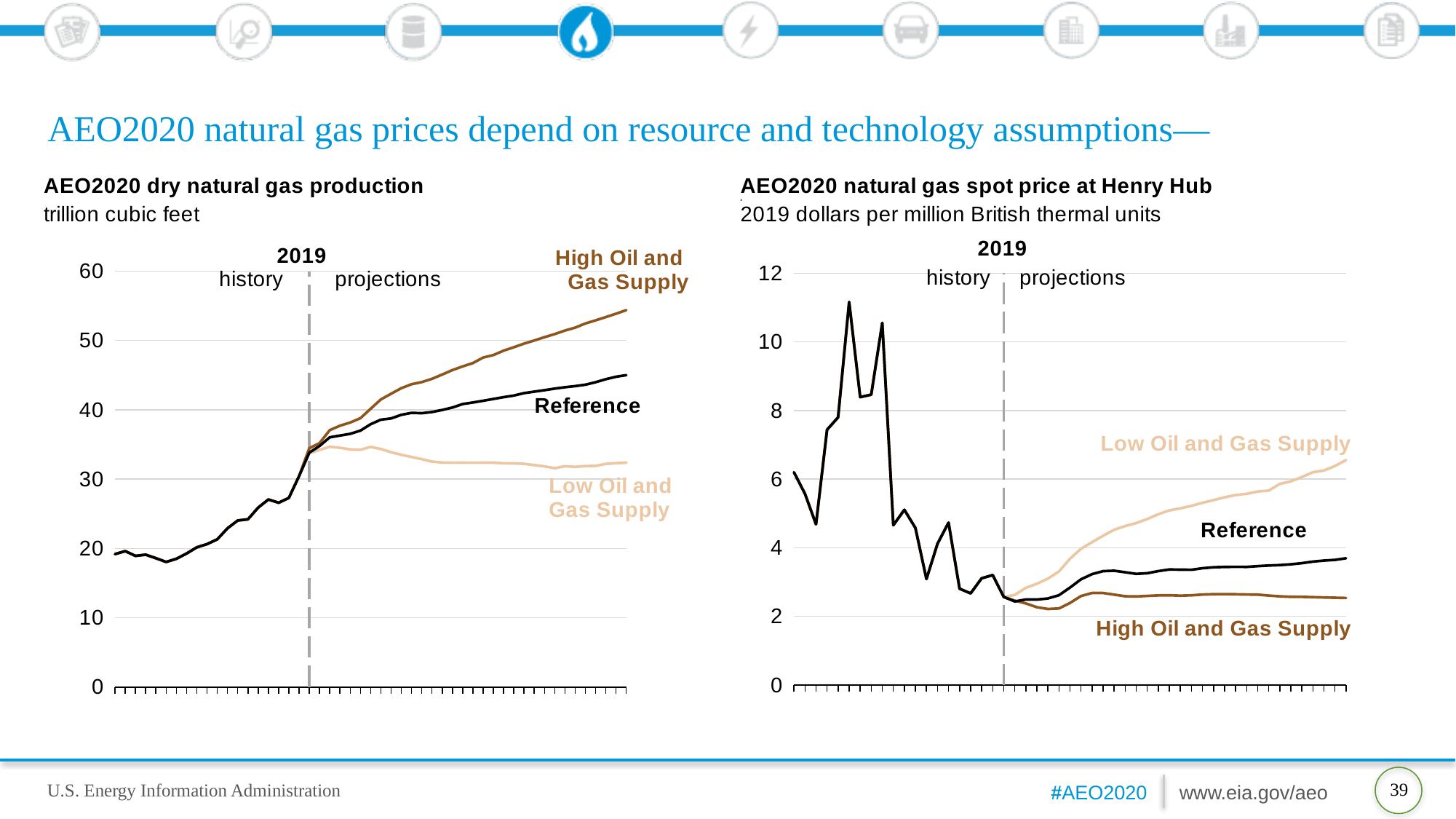
What unit is used on the 'AEO2020 natural gas spot price at Henry Hub' chart? 2019 dollars per million British thermal units On the 'AEO2020 natural gas spot price at Henry Hub' chart, is the Low Oil and Gas Supply value at the end of the projections greater or less than 6? greater On the 'AEO2020 dry natural gas production' chart, is the High Oil and Gas Supply value at the end of the projections greater or less than 50? greater What year separates history from projections on both charts? 2019 On the 'AEO2020 dry natural gas production' chart, which series is highest at the end of the projection period? High Oil and Gas Supply On the 'AEO2020 natural gas spot price at Henry Hub' chart, which series is lowest at the end of the projection period? High Oil and Gas Supply What kind of chart is the 'AEO2020 dry natural gas production' chart? line chart On the 'AEO2020 dry natural gas production' chart, is the Low Oil and Gas Supply value at the end of the projections greater or less than 40? less On the 'AEO2020 natural gas spot price at Henry Hub' chart, which is larger at the end of the projections: the Reference series or the Low Oil and Gas Supply series? Low Oil and Gas Supply On the 'AEO2020 dry natural gas production' chart, does the Reference series rise or fall over the projection period? rise How many series are plotted on the 'AEO2020 natural gas spot price at Henry Hub' chart? 3